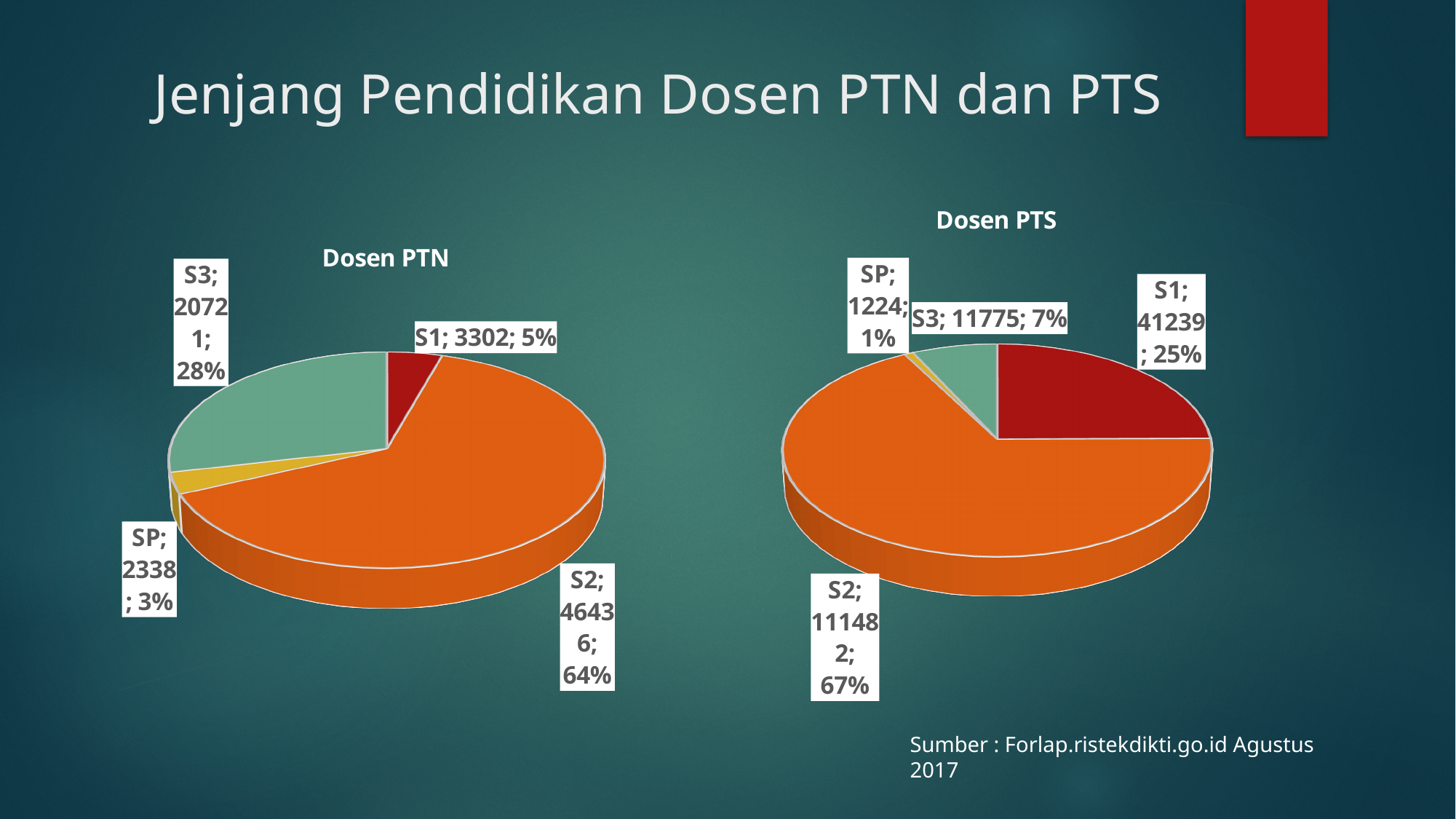
What kind of chart is the Dosen PTN chart? pie chart In the Dosen PTS chart, which category has the smallest slice? SP In the Dosen PTN chart, which category has the largest slice? S2 In the Dosen PTS chart, which is larger, the value for S1 or the value for S3? S1 How many categories does the Dosen PTS chart show? 4 In the Dosen PTN chart, what share of the pie does S3 represent? 28% What is the title of the chart on the right side of the slide? Dosen PTS In the Dosen PTN chart, what is the value for S1? 3302 In the Dosen PTS chart, what share of the pie does S1 represent? 25% In the Dosen PTS chart, what is the value for S3? 11775 In the Dosen PTN chart, which category has the smallest slice? SP In the Dosen PTN chart, what is the difference between the values for S1 and SP? 964